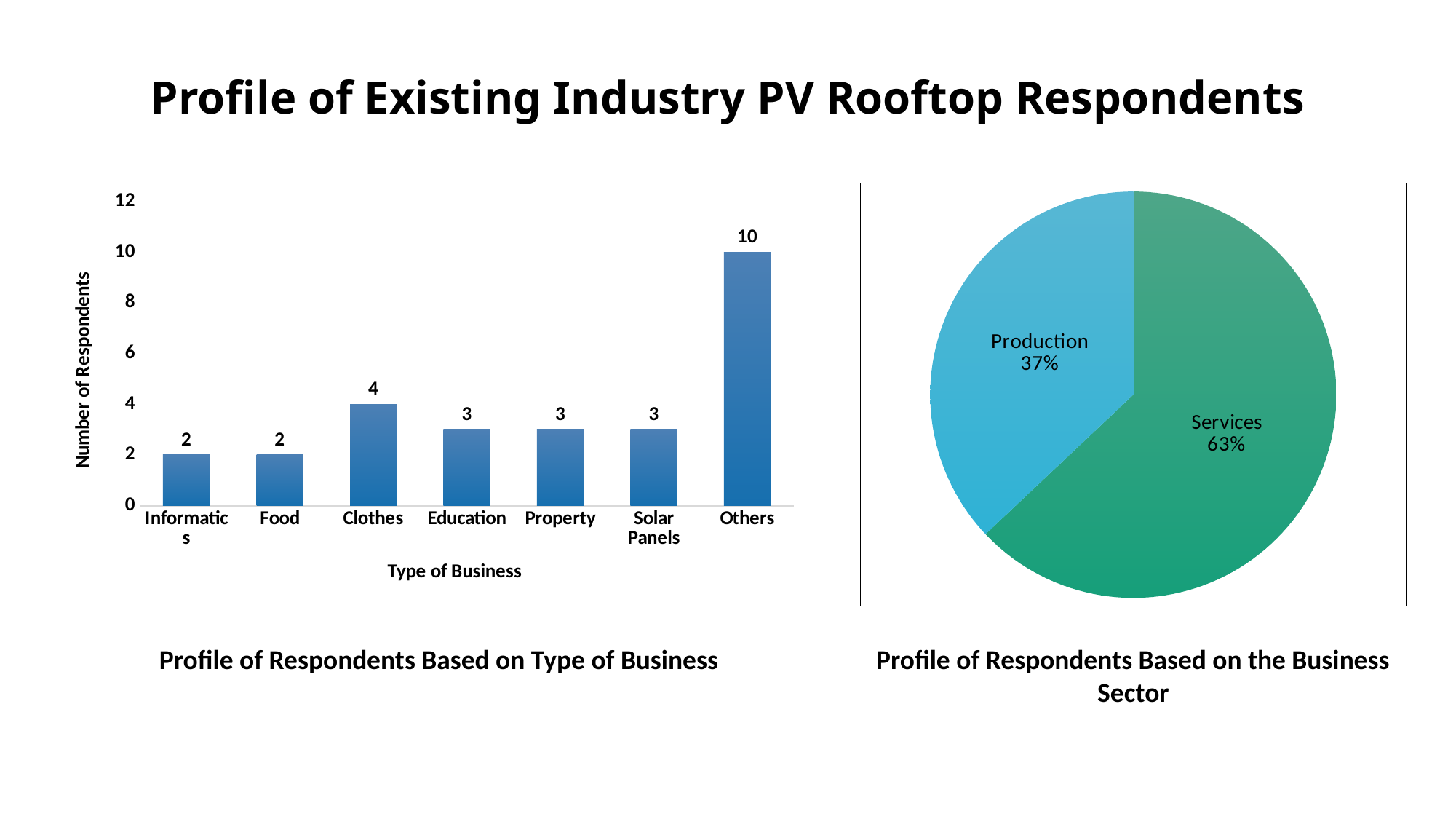
In the 'Profile of Respondents Based on Type of Business' chart, how many types of business are shown on the x axis? 7 In the 'Profile of Respondents Based on Type of Business' chart, what is the difference in respondents between Others and Clothes? 6 In the 'Profile of Respondents Based on Type of Business' chart, how many respondents are in the Clothes category? 4 What kind of chart is 'Profile of Respondents Based on Type of Business'? Bar chart In the 'Profile of Respondents Based on the Business Sector' chart, which sector has the larger share? Services What kind of chart is 'Profile of Respondents Based on the Business Sector'? Pie chart In the 'Profile of Respondents Based on Type of Business' chart, how many respondents are in the Others category? 10 In the 'Profile of Respondents Based on Type of Business' chart, which type of business has the highest number of respondents? Others In the 'Profile of Respondents Based on the Business Sector' chart, what share of respondents is in Services? 63% In the 'Profile of Respondents Based on Type of Business' chart, what is the label of the y axis? Number of Respondents In the 'Profile of Respondents Based on Type of Business' chart, which has more respondents, Clothes or Food? Clothes In the 'Profile of Respondents Based on the Business Sector' chart, what share of respondents is in Production? 37%